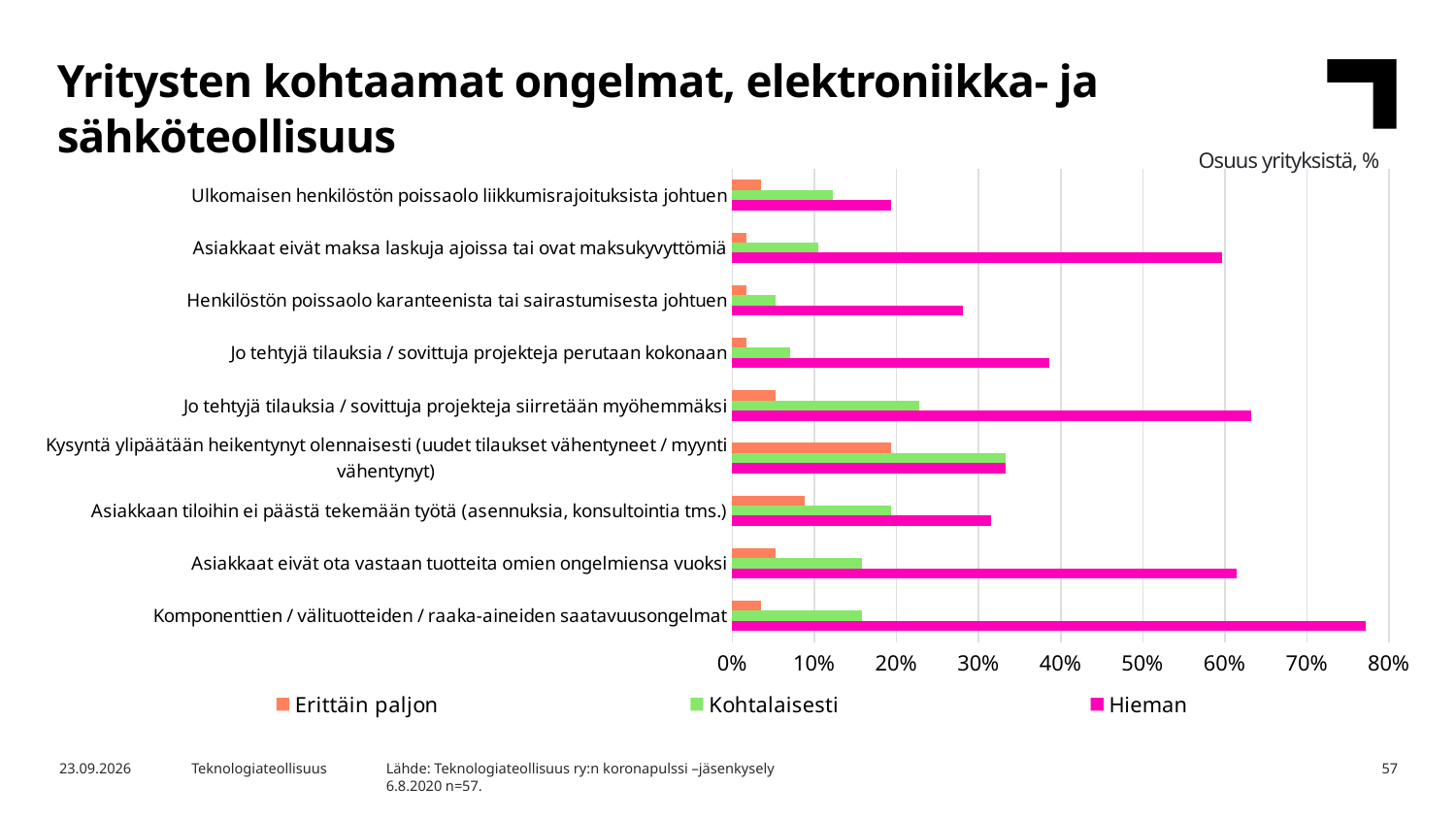
How many categories (problems) are plotted on the chart? 9 Is the 'Hieman' value for 'Komponenttien / välituotteiden / raaka-aineiden saatavuusongelmat' greater or less than 70%? greater Is the 'Erittäin paljon' value for 'Kysyntä ylipäätään heikentynyt olennaisesti' greater or less than 10%? greater What kind of chart is shown on the slide? Bar chart What unit label is shown above the chart's value axis? Osuus yrityksistä, % How many series does the legend list? 3 Is the 'Hieman' value for 'Asiakkaat eivät maksa laskuja ajoissa tai ovat maksukyvyttömiä' greater or less than 50%? greater Which category has the lowest value for the 'Hieman' series? Ulkomaisen henkilöstön poissaolo liikkumisrajoituksista johtuen Which category has the highest value for the 'Erittäin paljon' series? Kysyntä ylipäätään heikentynyt olennaisesti (uudet tilaukset vähentyneet / myynti vähentynyt) For the 'Kohtalaisesti' series, which is larger: 'Asiakkaan tiloihin ei päästä tekemään työtä' or 'Henkilöstön poissaolo karanteenista tai sairastumisesta johtuen'? Asiakkaan tiloihin ei päästä tekemään työtä Which category has the highest value for the 'Hieman' series? Komponenttien / välituotteiden / raaka-aineiden saatavuusongelmat For the 'Hieman' series, which is larger: 'Jo tehtyjä tilauksia / sovittuja projekteja siirretään myöhemmäksi' or 'Jo tehtyjä tilauksia / sovittuja projekteja perutaan kokonaan'? Jo tehtyjä tilauksia / sovittuja projekteja siirretään myöhemmäksi